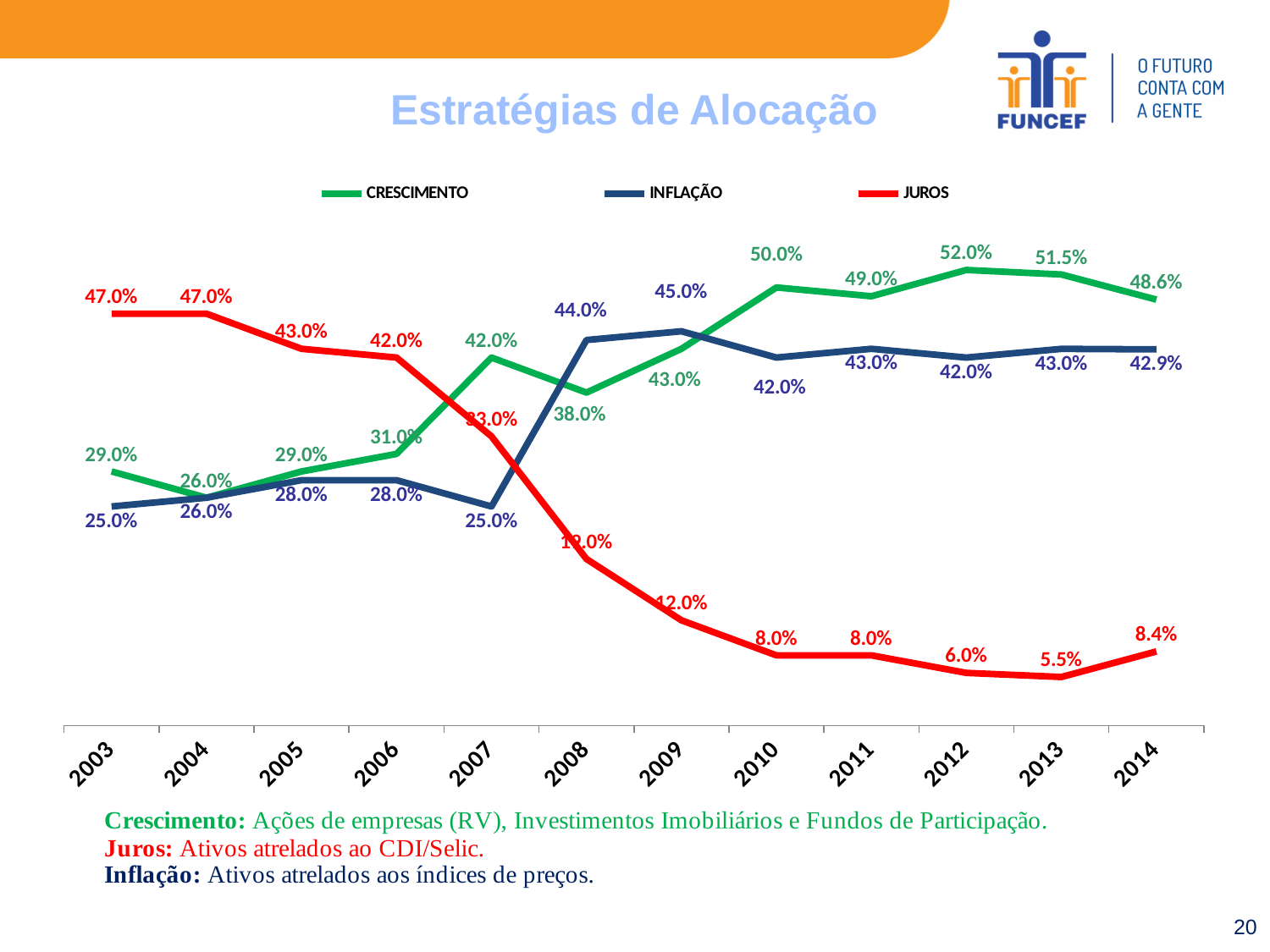
How many years are shown on the x axis? 12 What is the value of INFLAÇÃO in 2009? 45.0% In which year does JUROS reach its lowest value? 2013 What is the difference between the JUROS value in 2003 and in 2014? 38.6% What is the value of JUROS in 2014? 8.4% In which year does CRESCIMENTO reach its highest value? 2012 How many series does the legend list? 3 Which series has the larger value in 2005, CRESCIMENTO or JUROS? JUROS What type of chart is shown on the slide? Line chart What is the title of the chart? Estratégias de Alocação Does the JUROS series generally rise or fall from 2003 to 2013? Fall What is the value of CRESCIMENTO in 2012? 52.0%